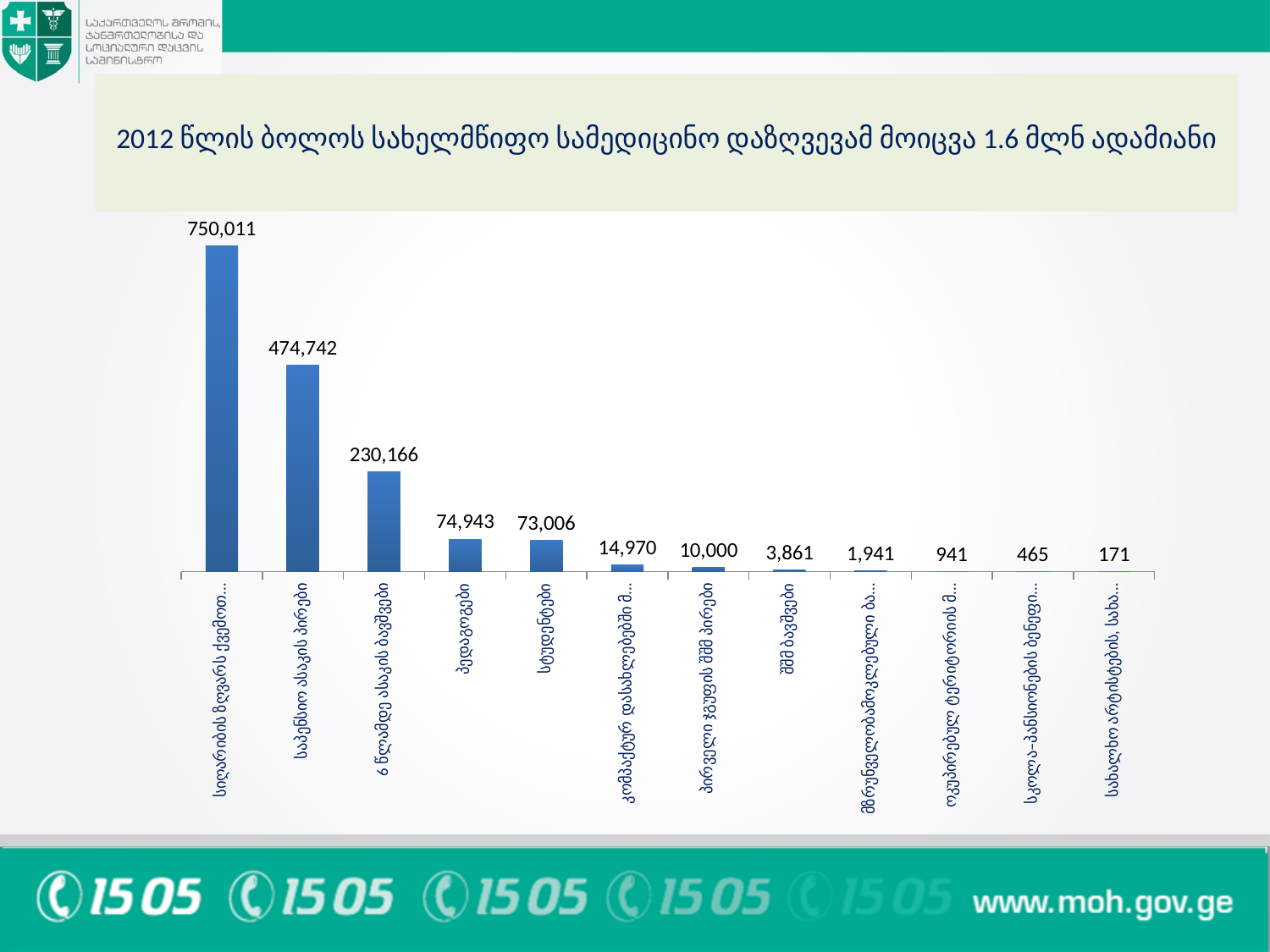
Do the values rise or fall from left to right along the x axis? fall What is the title of the slide above the chart? 2012 წლის ბოლოს სახელმწიფო სამედიცინო დაზღვევამ მოიცვა 1.6 მლნ ადამიანი What is the value for სტუდენტები? 73,006 Which category has the highest value? სიღარიბის ზღვარს ქვემოთ... What is the value for საპენსიო ასაკის პირები? 474,742 What is the value for შშმ ბავშვები? 3,861 Which category has the lowest value? სახალხო არტისტების, სახა... What is the value for პედაგოგები? 74,943 What type of chart is shown on the slide? bar chart What is the difference between the values for საპენსიო ასაკის პირები and 6 წლამდე ასაკის ბავშვები? 244,576 How many categories (bars) are plotted in the chart? 12 Which is larger, the value for პედაგოგები or the value for სტუდენტები? პედაგოგები